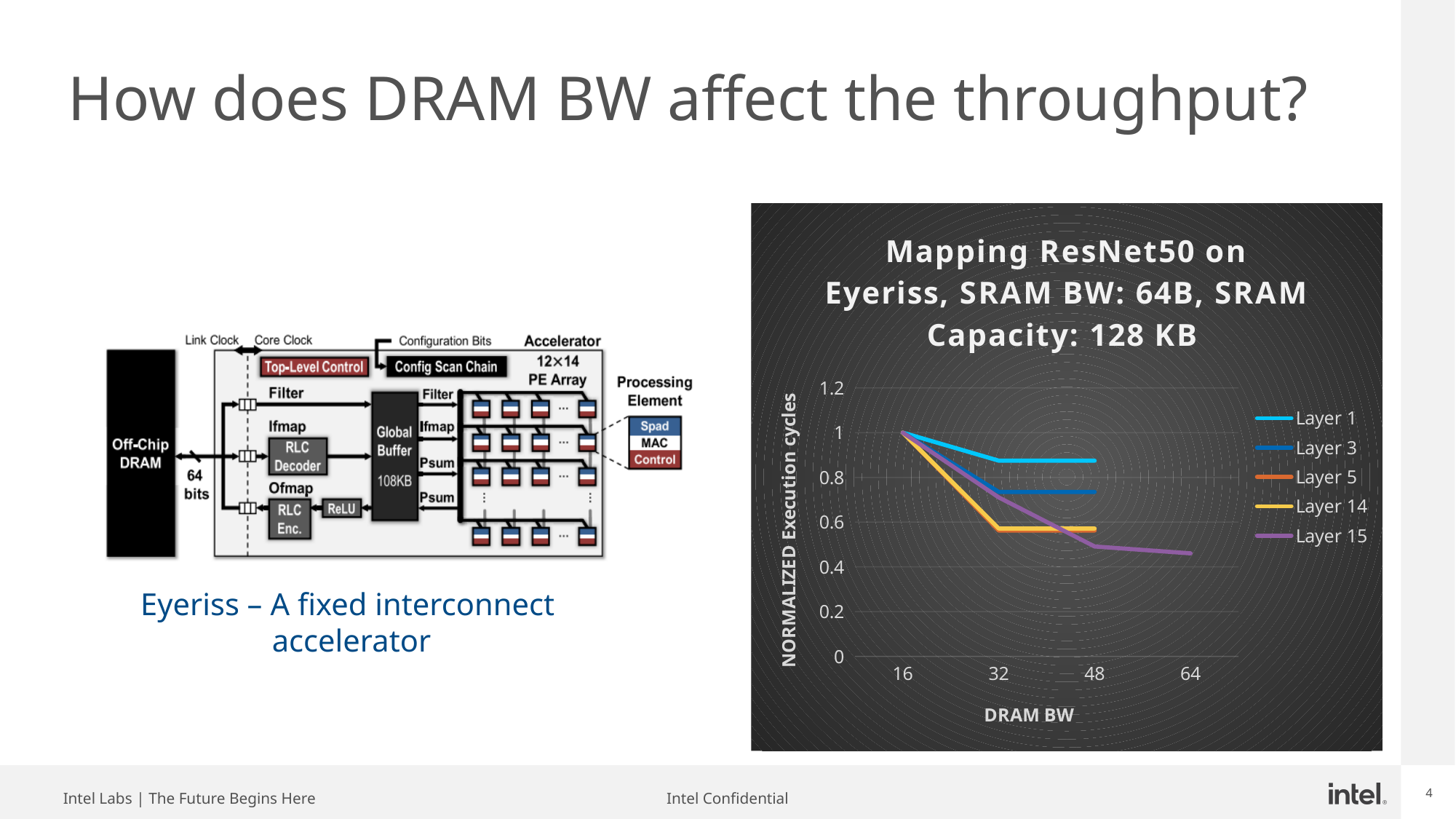
Is the value for Layer 15 at DRAM BW 64 greater or less than 0.6? less What is the title of the y axis of the chart? NORMALIZED Execution cycles At DRAM BW 32, which is larger: the value for Layer 1 or the value for Layer 14? Layer 1 What is the normalized execution cycles value for Layer 1 at DRAM BW 16? 1 What type of chart is shown on the slide? Line chart What is the title of the x axis of the chart? DRAM BW Do the normalized execution cycles for Layer 15 rise or fall as DRAM BW increases? Fall How many DRAM BW values are marked on the x axis of the chart? 4 Is the value for Layer 1 at DRAM BW 32 greater or less than 0.8? greater How many series does the legend of the chart list? 5 Which layer has the highest normalized execution cycles at DRAM BW 32? Layer 1 Is the value for Layer 14 at DRAM BW 48 greater or less than 0.8? less